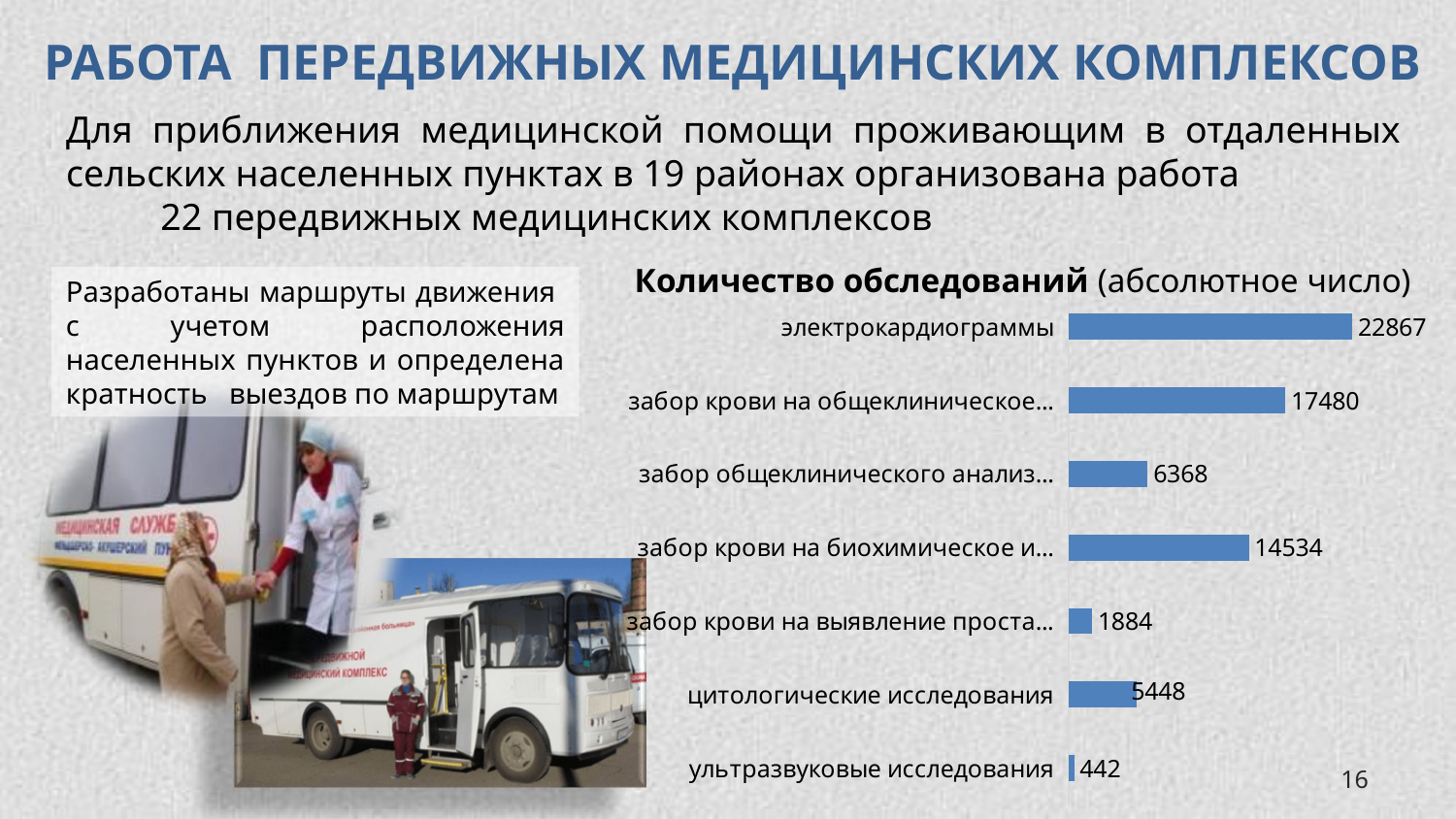
How many categories are shown in the chart? 7 What is the difference between the value for электрокардиограммы and the value for the category beginning 'забор крови на общеклиническое'? 5387 What is the value for the category beginning 'забор крови на биохимическое'? 14534 Which is larger: the value for цитологические исследования or the value for the category beginning 'забор общеклинического анализ'? забор общеклинического анализ… Which category has the lowest value? ультразвуковые исследования What is the value for цитологические исследования? 5448 What is the difference between the value for цитологические исследования and the value for ультразвуковые исследования? 5006 What is the value for электрокардиограммы? 22867 Which category has the highest value? электрокардиограммы What type of chart is shown on the slide? bar chart What is the value for ультразвуковые исследования? 442 What is the title of the chart? Количество обследований (абсолютное число)